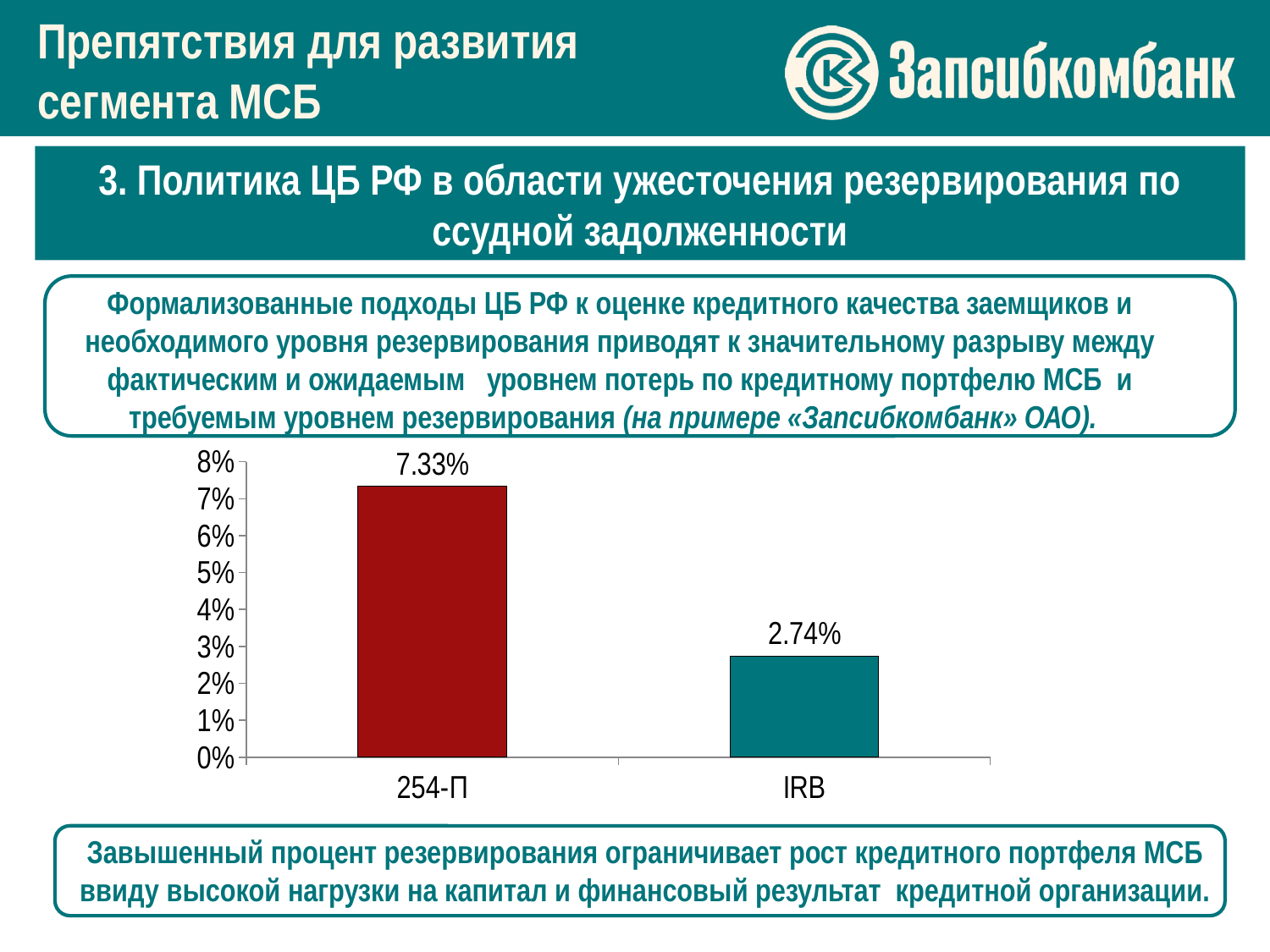
What is the highest value shown on the vertical axis? 8% What is the value for IRB? 2.74% What is the value for 254-П? 7.33% Which is larger, the value for 254-П or the value for IRB? 254-П What kind of chart is shown on the slide? bar chart Is the value for 254-П greater or less than 7%? greater What is the difference between the values for 254-П and IRB? 4.59% Is the value for IRB greater or less than 3%? less Which category has the highest value? 254-П Which category has the lowest value? IRB How many categories are shown on the chart? 2 What colour is the bar for 254-П? dark red